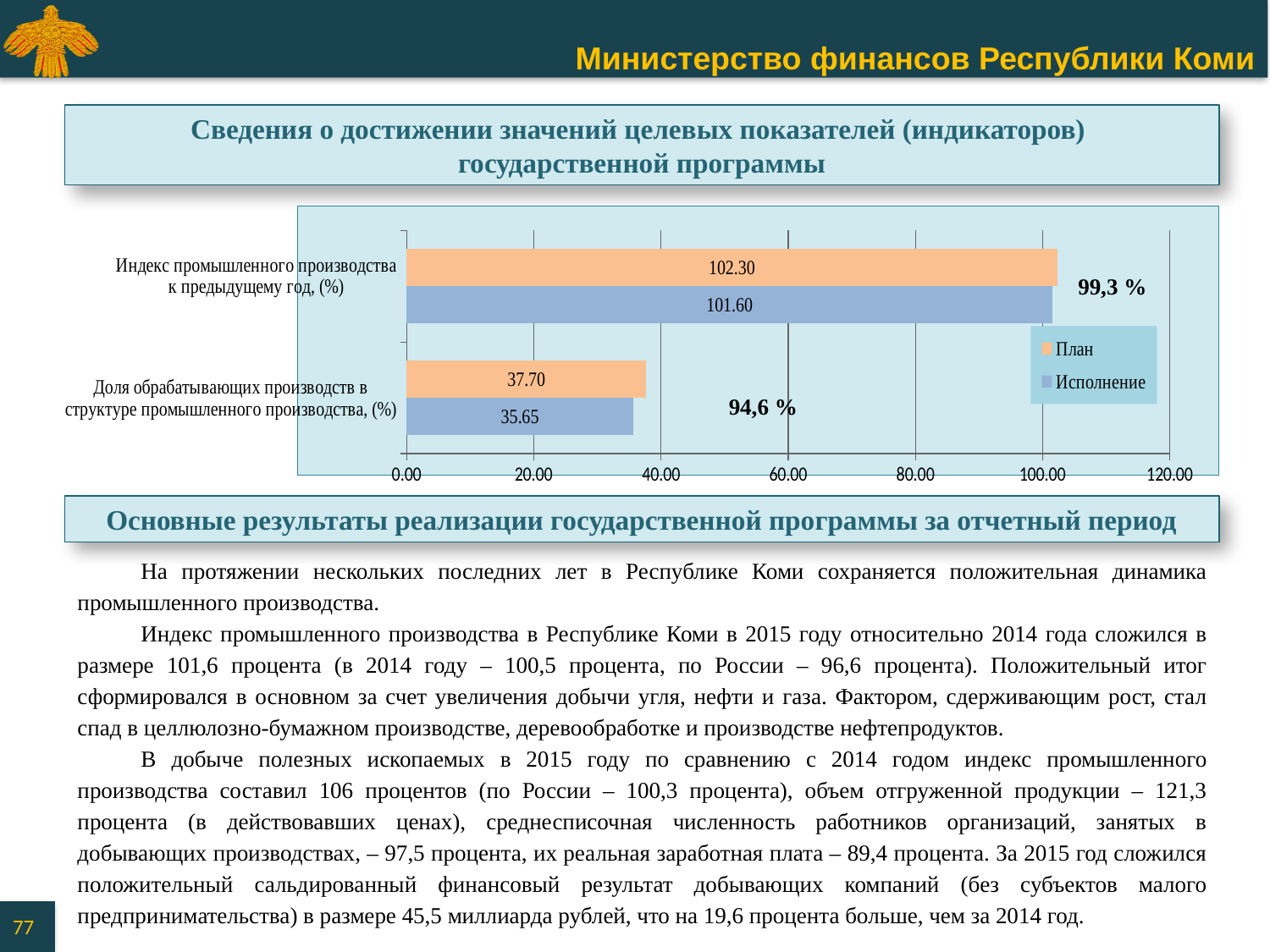
Which category has the lowest План value? Доля обрабатывающих производств в структуре промышленного производства, (%) What is the difference between the План and Исполнение values for «Индекс промышленного производства к предыдущему году, (%)»? 0.70 What is the Исполнение value for «Доля обрабатывающих производств в структуре промышленного производства, (%)»? 35.65 Is the Исполнение value for «Доля обрабатывающих производств в структуре промышленного производства, (%)» greater or less than 40.00? less What is the План value for «Индекс промышленного производства к предыдущему году, (%)»? 102.30 What is the Исполнение value for «Индекс промышленного производства к предыдущему году, (%)»? 101.60 What is the План value for «Доля обрабатывающих производств в структуре промышленного производства, (%)»? 37.70 How many series does the legend list? 2 For «Индекс промышленного производства к предыдущему году, (%)», which is larger: План or Исполнение? План What is the difference between the План and Исполнение values for «Доля обрабатывающих производств в структуре промышленного производства, (%)»? 2.05 What type of chart is shown on the slide? bar chart Which category has the higher Исполнение value? Индекс промышленного производства к предыдущему году, (%)